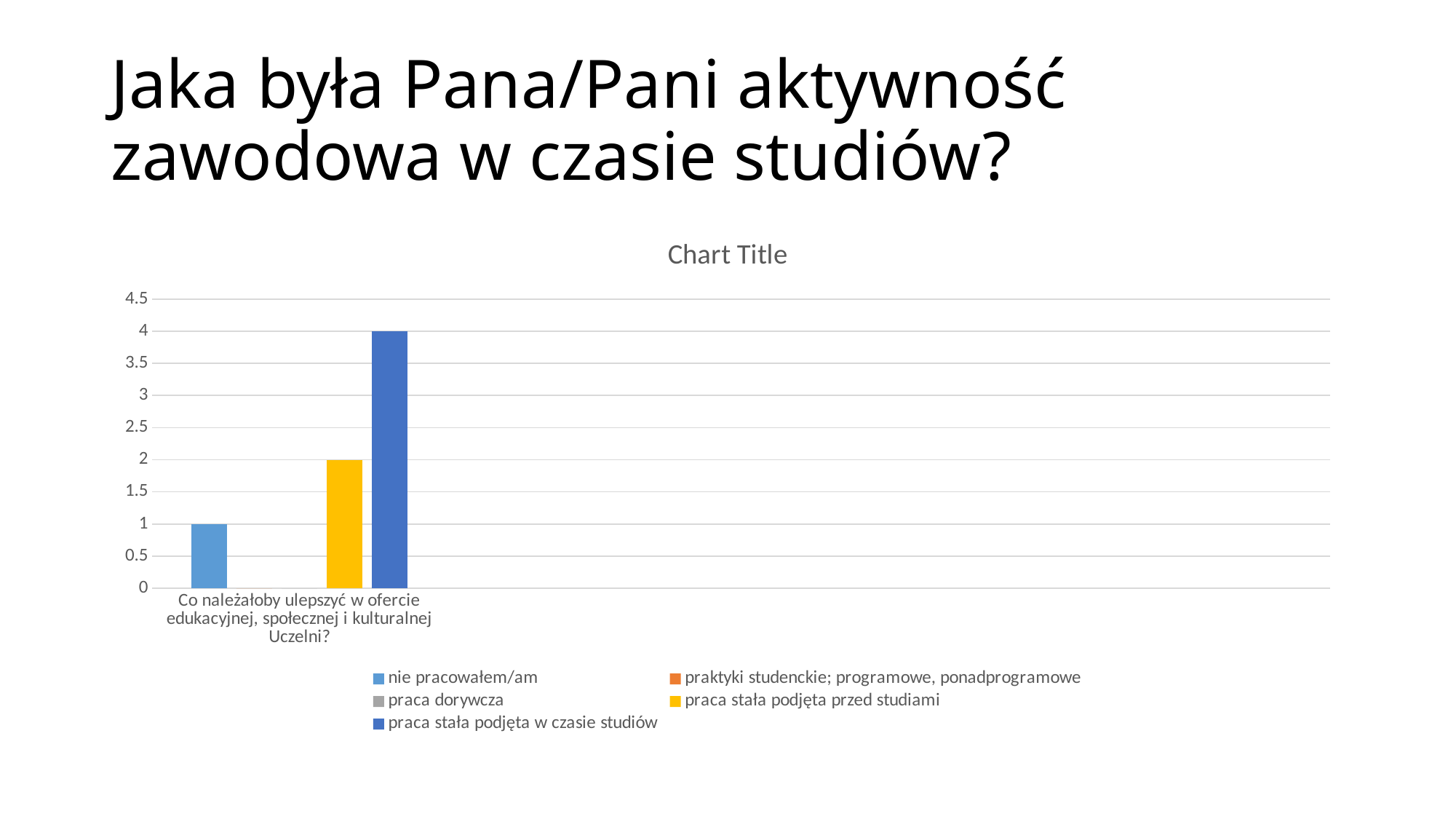
What is the value for "praca stała podjęta przed studiami"? 2 What is the difference between the values for "praca stała podjęta w czasie studiów" and "praca stała podjęta przed studiami"? 2 What is the value for "praca stała podjęta w czasie studiów"? 4 What is the title shown above the chart? Chart Title Is the value for "praca stała podjęta w czasie studiów" greater or less than 3? greater How many series does the legend list? 5 Which is larger, the value for "nie pracowałem/am" or the value for "praca stała podjęta przed studiami"? praca stała podjęta przed studiami Which series has the highest value? praca stała podjęta w czasie studiów How many categories are shown on the x axis? 1 What colour is the bar for "praca stała podjęta przed studiami"? yellow What kind of chart is shown on the slide? bar chart What is the value for "nie pracowałem/am"? 1